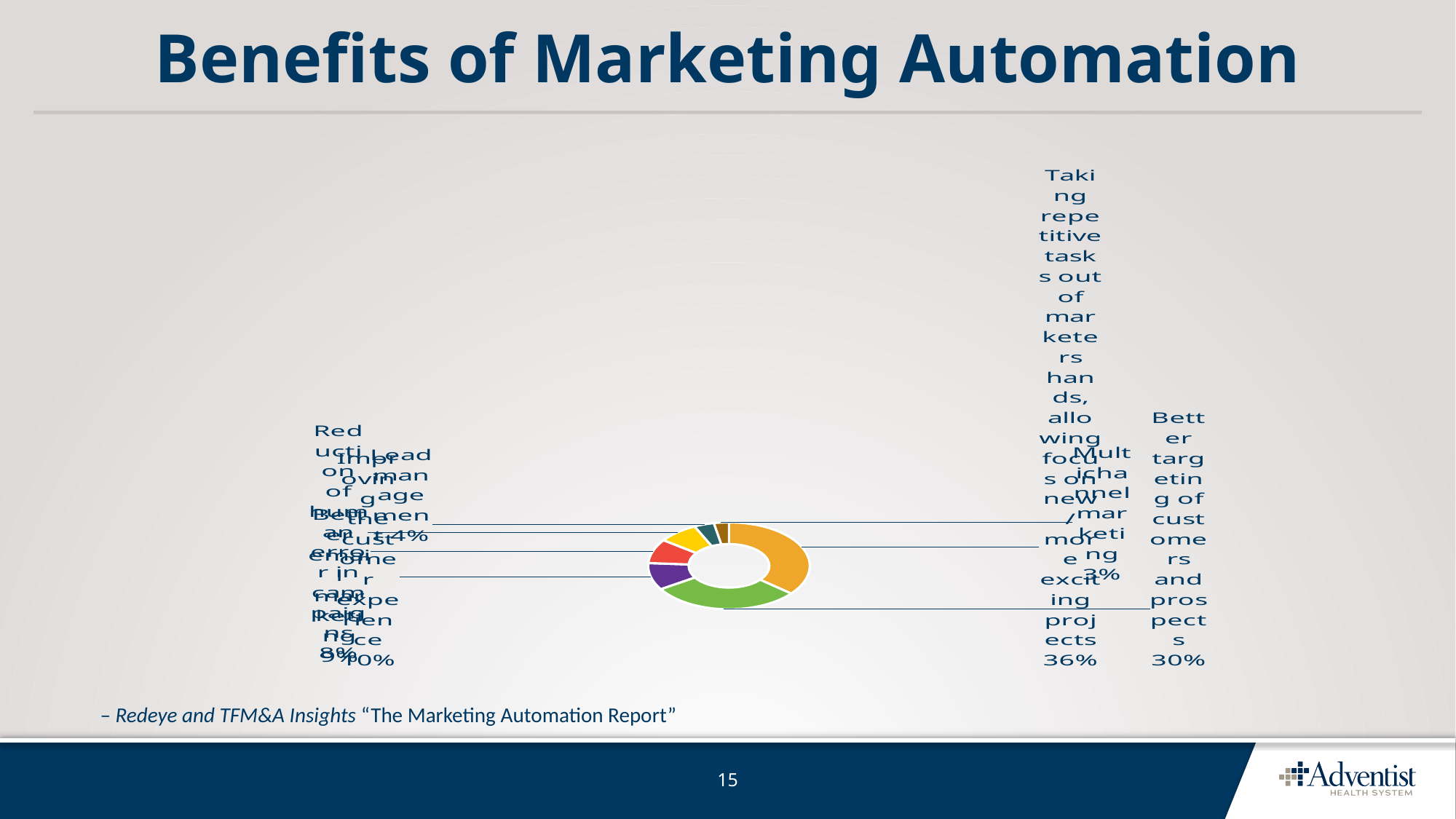
What source is cited below the chart? Redeye and TFM&A Insights "The Marketing Automation Report" Which benefit has the smallest share of the chart? Multichannel marketing What is the title of the slide containing the chart? Benefits of Marketing Automation What percentage is shown for 'Taking repetitive tasks out of marketers hands, allowing focus on new / more exciting projects'? 36% What percentage is shown for 'Multichannel marketing'? 3% What is the difference in percentage points between 'Taking repetitive tasks out of marketers hands' (36%) and 'Better targeting of customers and prospects' (30%)? 6 percentage points What percentage is shown for 'Lead management'? 4% What kind of chart is shown on the slide? Pie (doughnut) chart Which is larger: the share for 'Taking repetitive tasks out of marketers hands' or for 'Better targeting of customers and prospects'? Taking repetitive tasks out of marketers hands Which benefit has the largest share of the chart? Taking repetitive tasks out of marketers hands, allowing focus on new / more exciting projects What percentage is shown for 'Better targeting of customers and prospects'? 30%